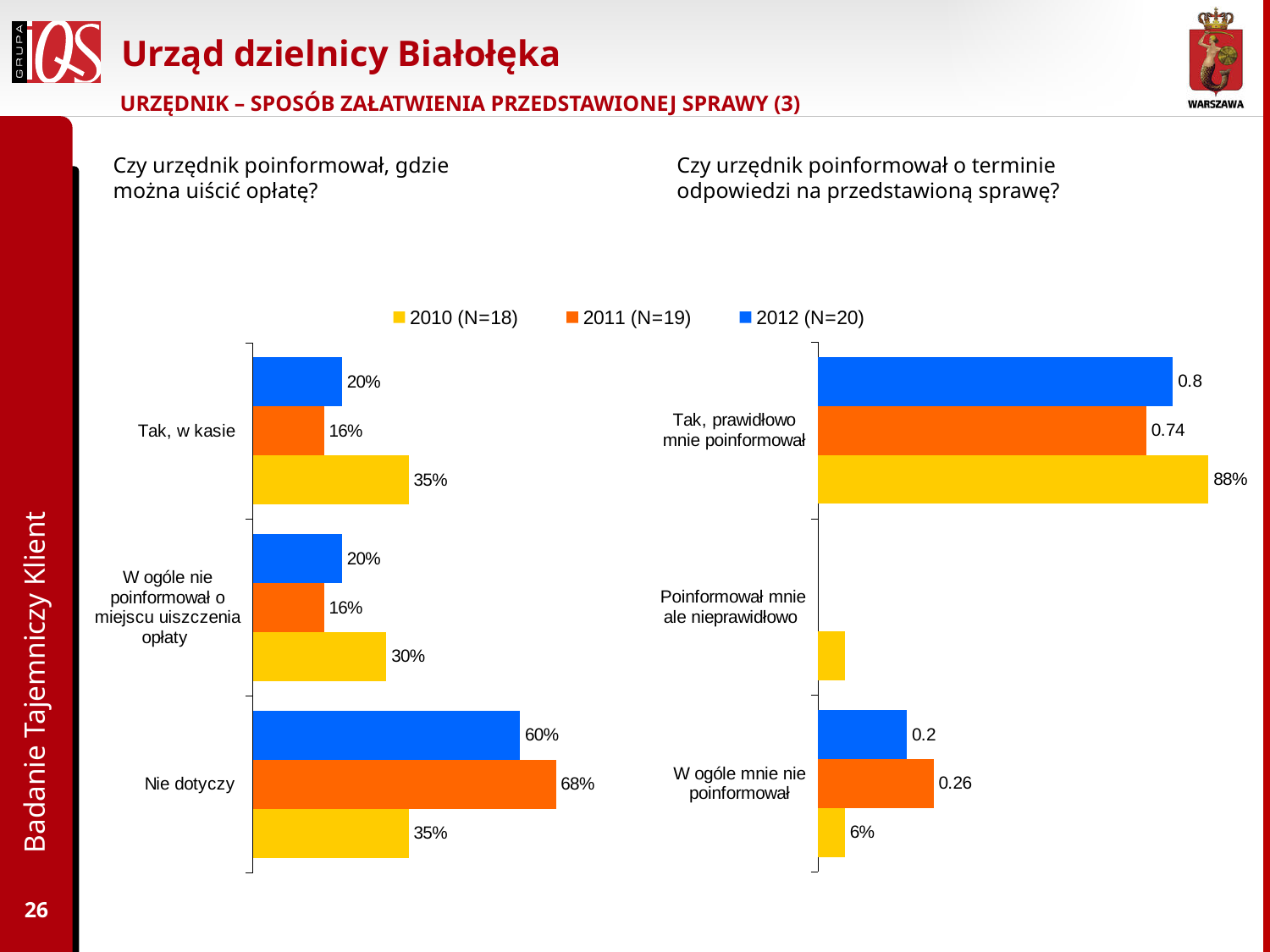
In the left chart (Czy urzędnik poinformował, gdzie można uiścić opłatę?), what is the value for 'Tak, w kasie' in 2010 (N=18)? 35% In the left chart, what is the difference between the 2011 (N=19) and 2012 (N=20) values for 'Nie dotyczy'? 8% In the right chart (Czy urzędnik poinformował o terminie odpowiedzi na przedstawioną sprawę?), what is the value for 'Tak, prawidłowo mnie poinformował' in 2012 (N=20)? 0.8 In the left chart, which category has the highest value for 2012 (N=20)? Nie dotyczy How many series does the legend list? 3 In the left chart, which is larger for 'W ogóle nie poinformował o miejscu uiszczenia opłaty': the 2010 (N=18) value or the 2012 (N=20) value? 2010 (N=18) In the right chart (Czy urzędnik poinformował o terminie odpowiedzi na przedstawioną sprawę?), what is the value for 'W ogóle mnie nie poinformował' in 2010 (N=18)? 6% How many categories are shown in the left chart? 3 In the left chart (Czy urzędnik poinformował, gdzie można uiścić opłatę?), what is the value for 'Nie dotyczy' in 2011 (N=19)? 68% In the right chart, which is larger for 'W ogóle mnie nie poinformował': the 2011 (N=19) value or the 2012 (N=20) value? 2011 (N=19) What type of chart is used on this slide? Bar chart In the right chart, which category has the lowest labelled value for 2011 (N=19)? W ogóle mnie nie poinformował